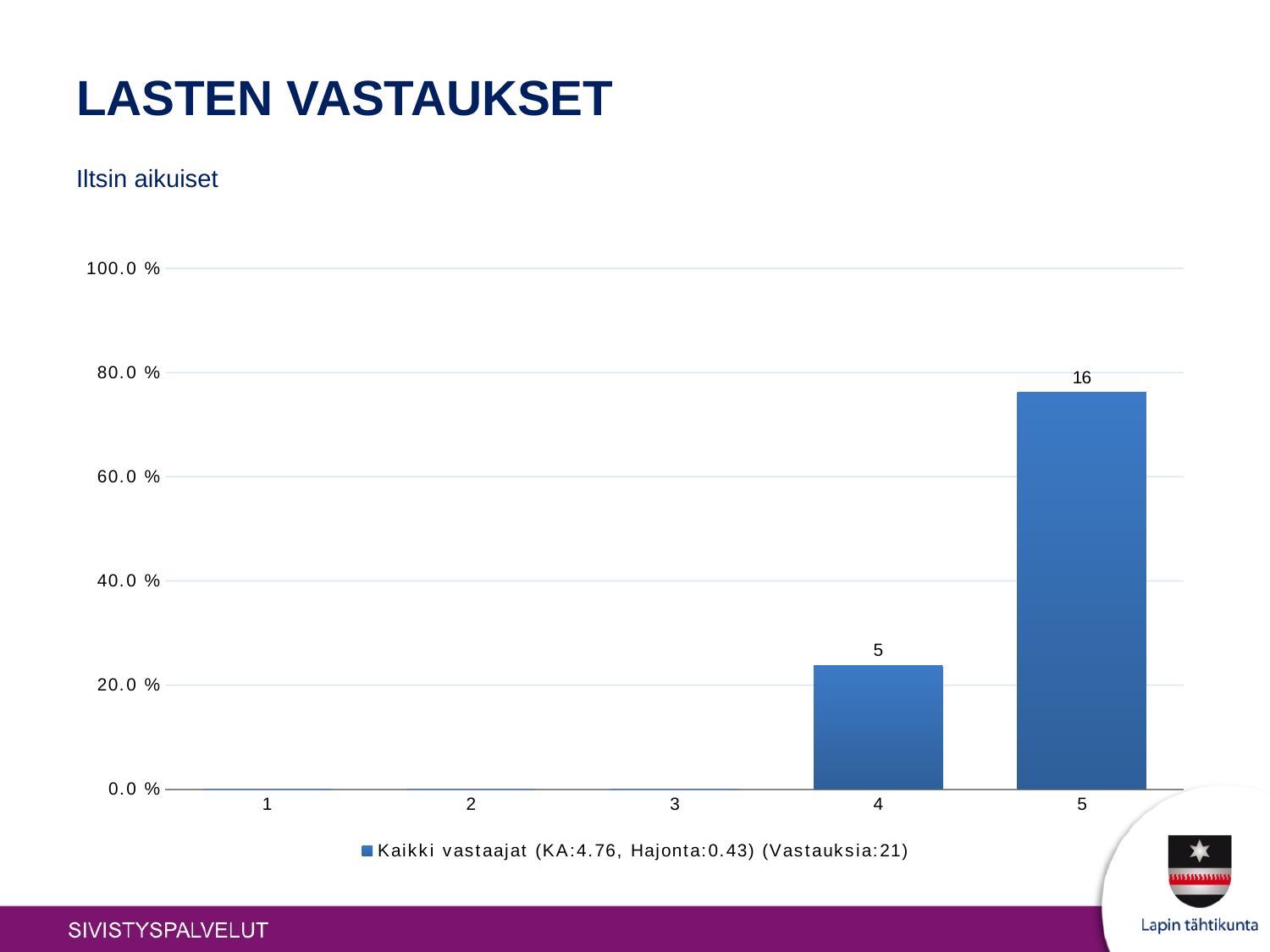
Is the value for category 5 greater or less than 60.0 %? greater How many series does the legend list? 1 Is the value for category 4 greater or less than 40.0 %? less What is the legend entry for the series? Kaikki vastaajat (KA:4.76, Hajonta:0.43) (Vastauksia:21) Which bar is taller, category 4 or category 5? 5 What type of chart is shown on the slide? bar chart What is the difference between the data labels for category 5 and category 4? 11 Do the bar values rise or fall from category 1 to category 5? rise What data label is shown on the bar for category 5? 16 What data label is shown on the bar for category 4? 5 How many categories are shown on the x axis? 5 Which category has the highest bar? 5